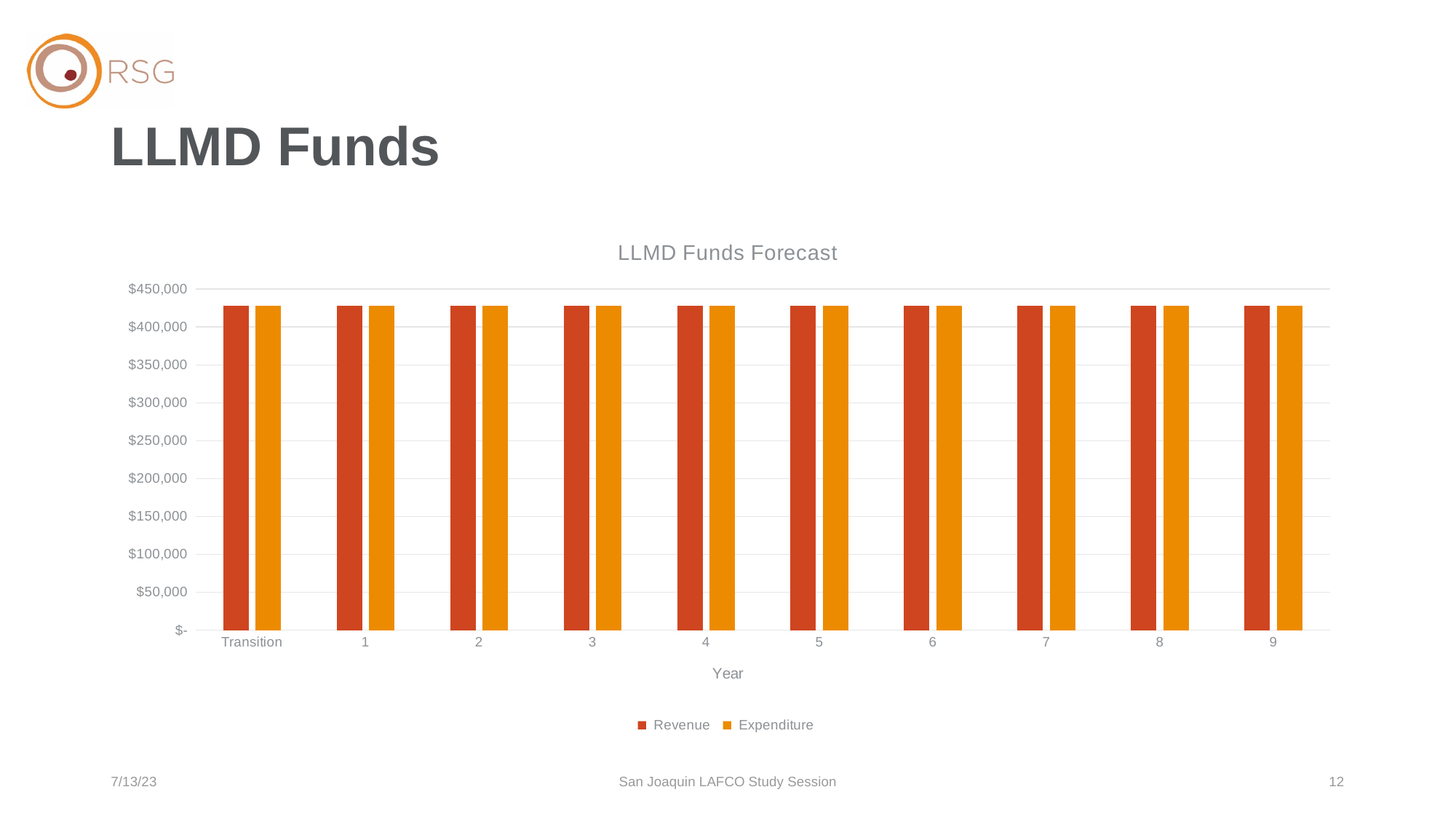
Do the Revenue values rise, fall, or stay flat from Transition to year 9? stay flat What kind of chart is shown on the slide? bar chart Is the Revenue value for year 9 greater or less than $350,000? greater Is the Revenue value for Transition greater or less than $400,000? greater How many categories are shown along the x axis? 10 What is the title of the chart? LLMD Funds Forecast What is the label of the x axis? Year How many series does the legend list? 2 Is the Revenue value for year 4 greater or less than $450,000? less Do the Expenditure values rise, fall, or stay flat across the years? stay flat